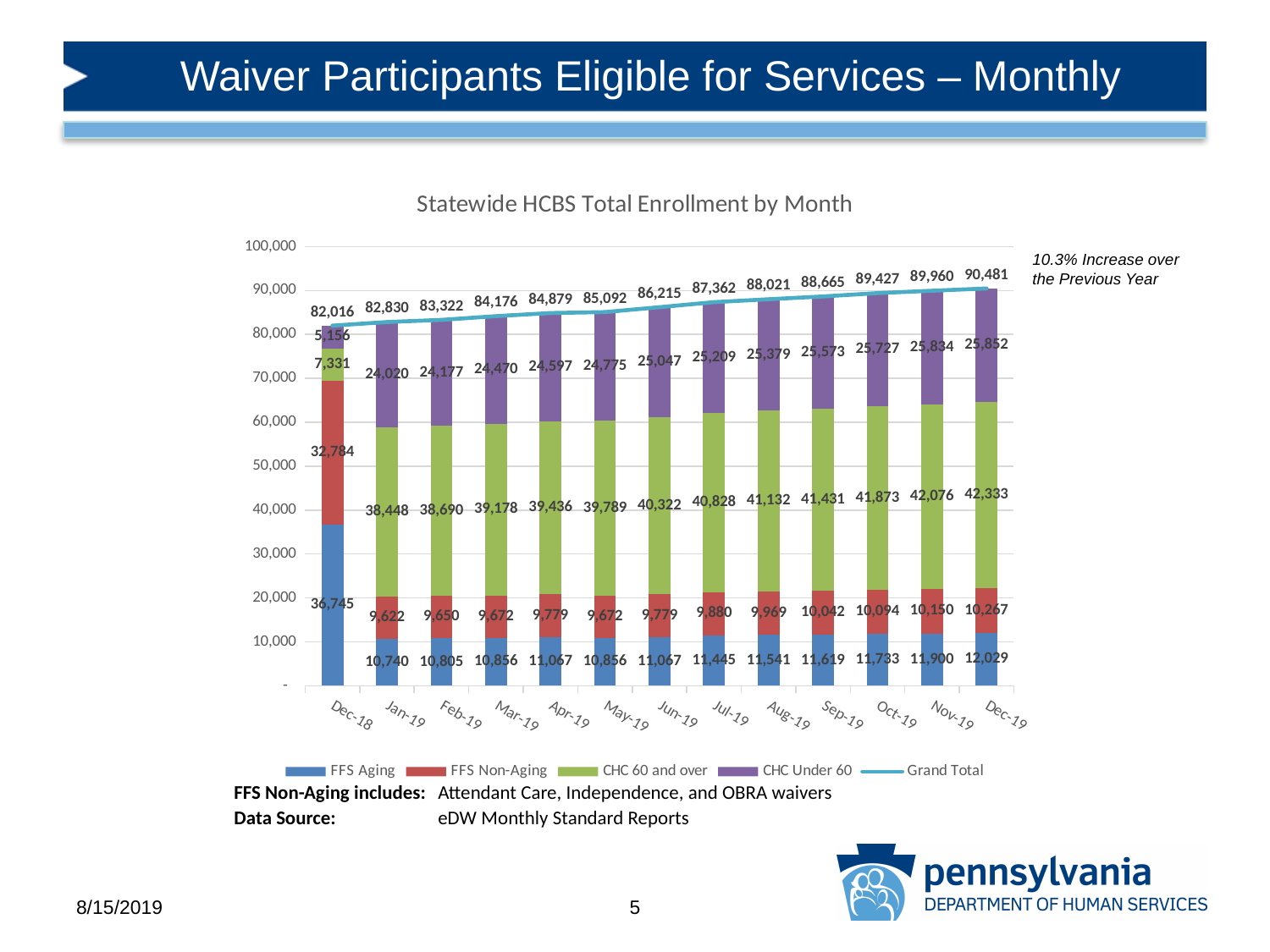
What is the CHC 60 and over value for Jun-19? 40,322 Which month has the lowest FFS Aging value? Jan-19 What kind of chart is shown on the slide? stacked bar and line chart Which month has the highest Grand Total? Dec-19 What percentage increase over the previous year is noted next to the chart? 10.3% What is the difference between the Grand Total for Dec-19 and the Grand Total for Dec-18? 8,465 What is the FFS Aging value for Dec-18? 36,745 How many series does the chart's legend list? 5 Does the Grand Total rise or fall from Dec-18 to Dec-19? rise Which is larger, the CHC Under 60 value for Dec-18 or for Jan-19? Jan-19 What is the Grand Total value for Dec-19? 90,481 How many months are shown along the x axis of the chart? 13